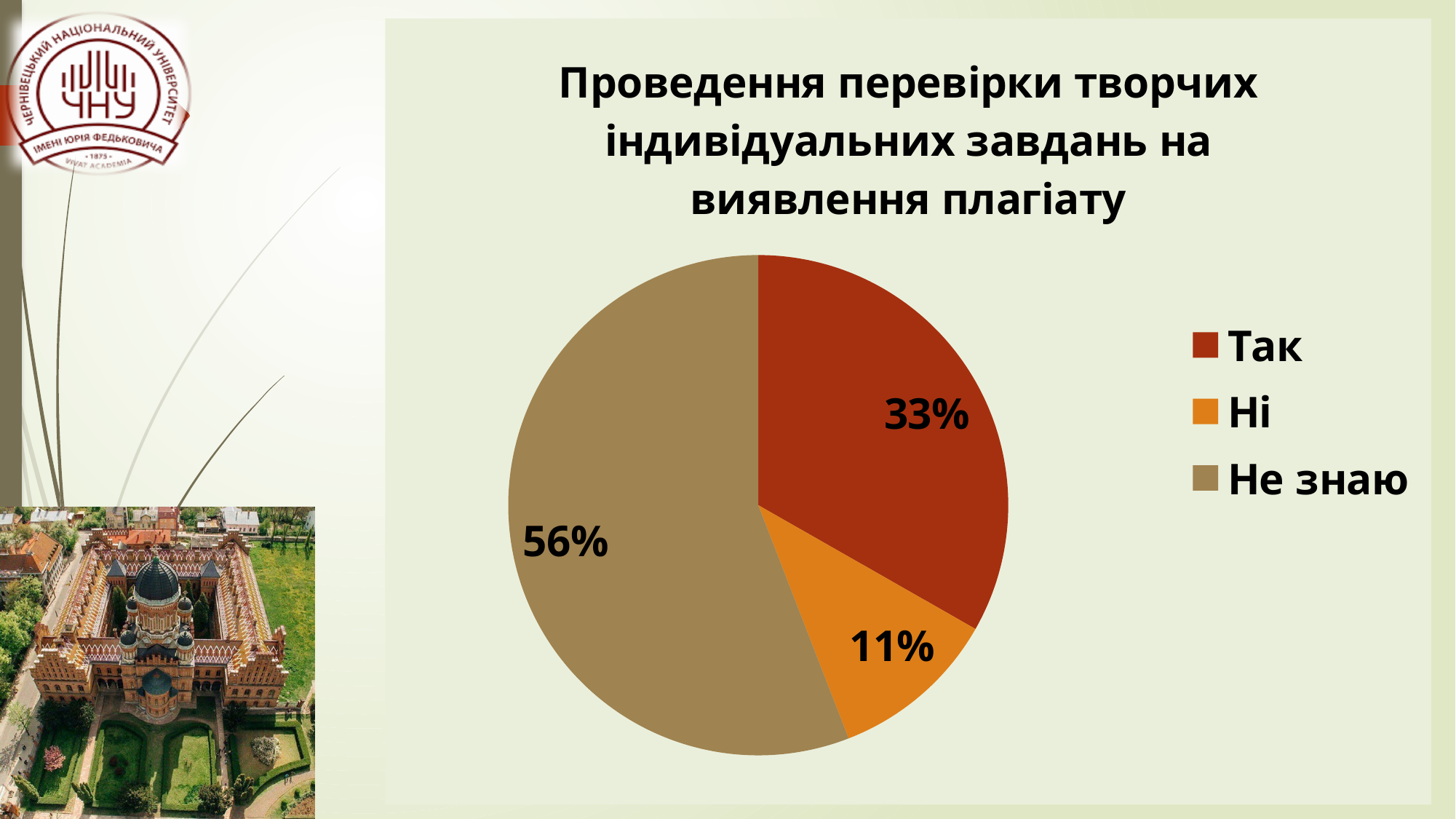
Which is larger, the share for "Так" or the share for "Ні"? Так What kind of chart is shown on the slide? Pie chart What share of the pie does "Ні" represent? 11% What share of the pie does "Не знаю" represent? 56% Which category has the largest slice of the pie? Не знаю What colour is the slice for "Ні"? Orange What is the title of the chart? Проведення перевірки творчих індивідуальних завдань на виявлення плагіату What share of the pie does "Так" represent? 33% Which category has the smallest slice of the pie? Ні What is the difference in percentage points between "Не знаю" and "Так"? 23 How many categories are shown in the pie chart? 3 What is the difference in percentage points between "Так" and "Ні"? 22